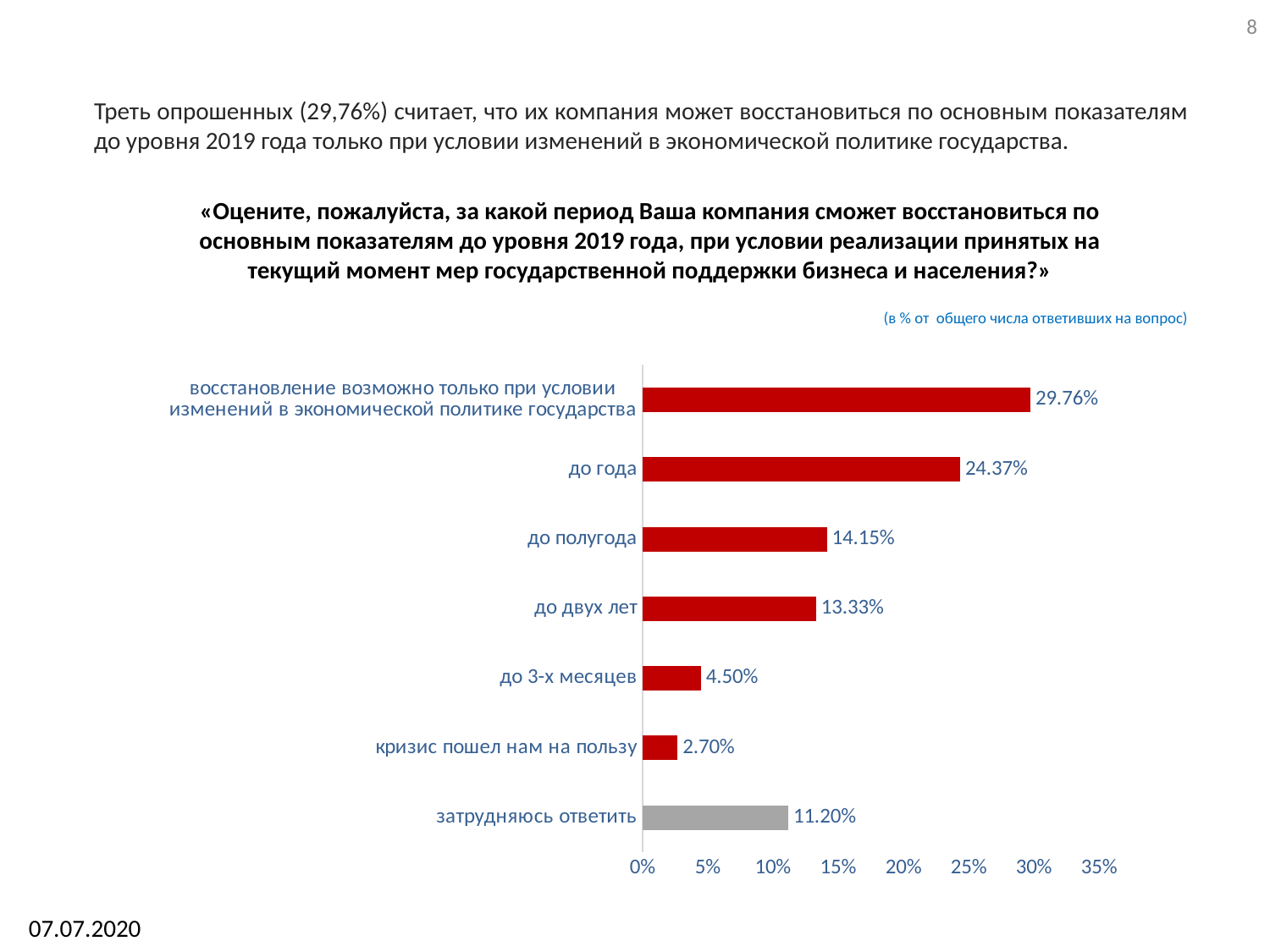
What is the value for "кризис пошел нам на пользу"? 2.70% What kind of chart is shown on the slide? bar chart What is the value for "до года"? 24.37% How many categories are shown in the chart? 7 Which is larger, the value for "до двух лет" or the value for "до 3-х месяцев"? до двух лет What is the value for "до полугода"? 14.15% What is the difference between the values for "до года" and "до полугода"? 10.22% What is the value for "затрудняюсь ответить"? 11.20% Which category has the lowest value? кризис пошел нам на пользу Which bar is coloured grey rather than red? затрудняюсь ответить Which category has the highest value? восстановление возможно только при условии изменений в экономической политике государства Is the value for "до года" greater or less than 20%? greater